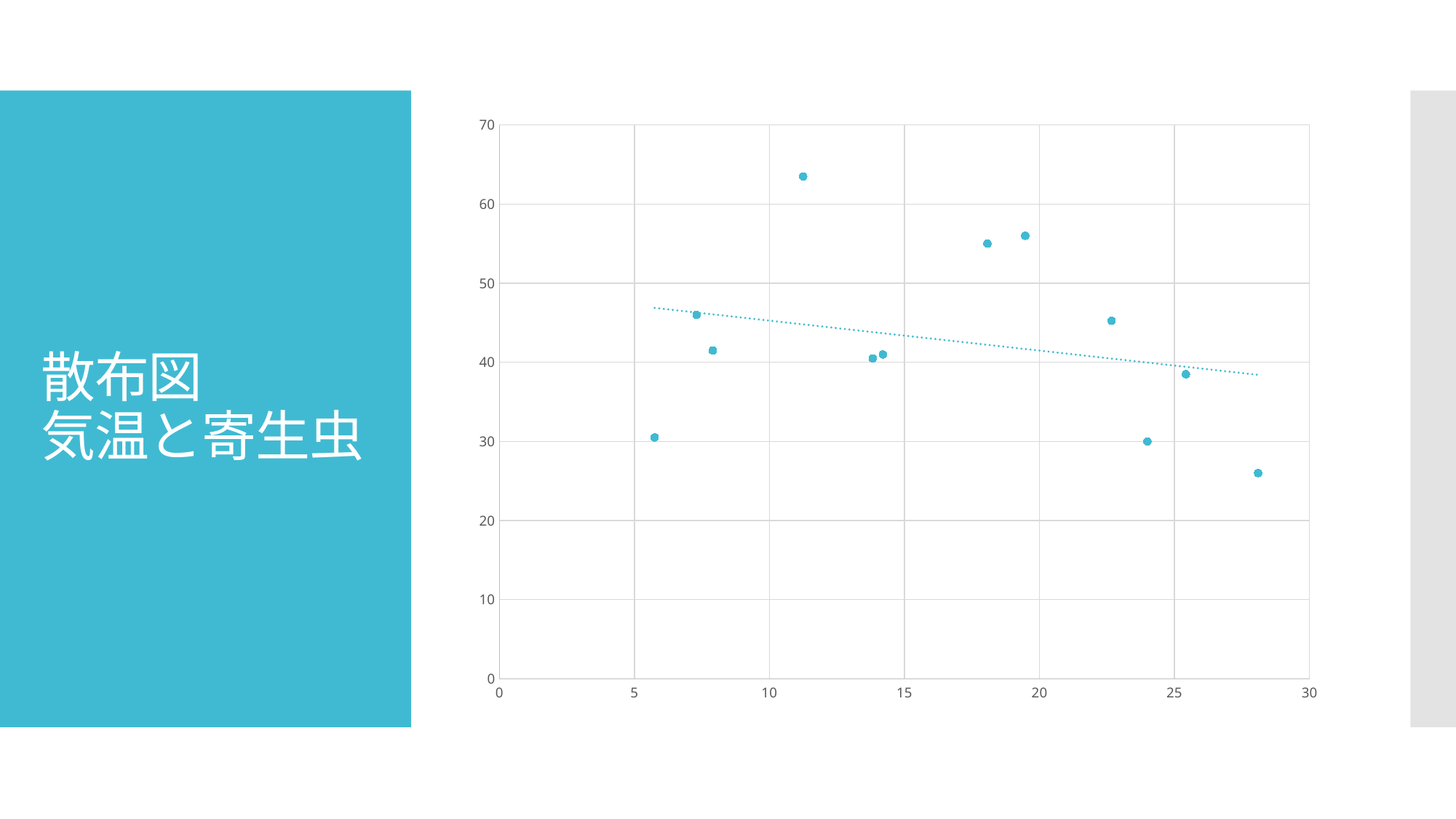
Does the dotted trendline on the chart rise or fall as the x value increases? fall What is the highest value shown on the y axis? 70 What kind of chart is shown on the slide? scatter chart What is the highest value shown on the x axis? 30 How many points on the chart have a y value above 50? 3 Is the y value of the point near x = 11 greater or less than 60? greater How many data points are plotted on the scatter chart? 12 Which has the larger y value: the point near x = 11 or the point near x = 28? the point near x = 11 Is the y value of the point at the far right of the chart (x near 28) greater or less than 30? less Is the y value of the highest point on the chart greater or less than 60? greater